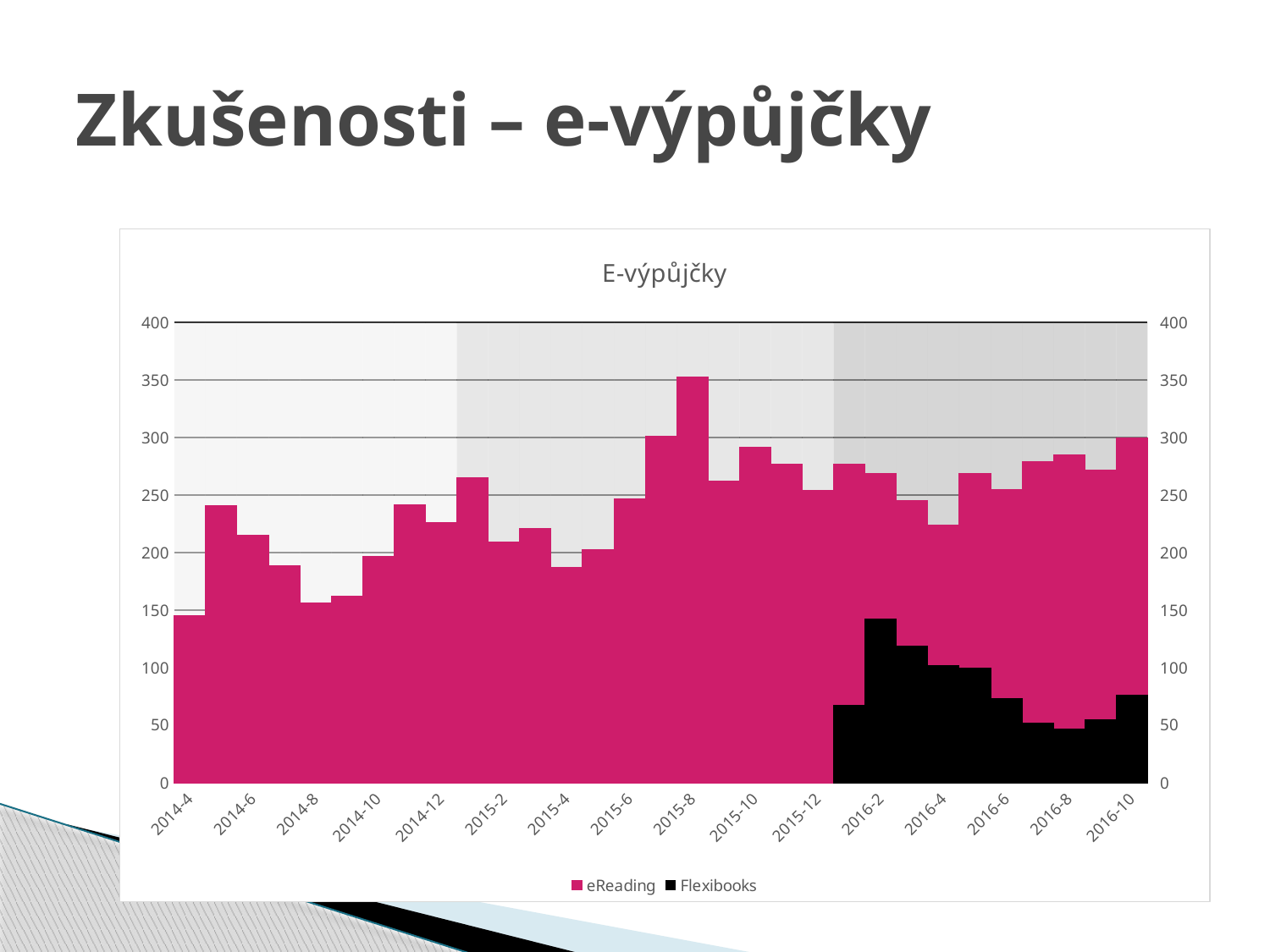
What kind of chart is shown on the slide? bar chart Is the stacked total for 2014-6 greater or less than 200? greater Is the Flexibooks value for 2016-8 greater or less than 100? less How many month labels are printed on the x axis? 16 What are the two series named in the legend? eReading and Flexibooks Is the Flexibooks value for 2016-2 greater or less than 100? greater What is the title of the chart? E-výpůjčky How many series does the legend list? 2 Which is larger, the stacked total for 2015-8 or for 2015-10? 2015-8 Does the Flexibooks series rise or fall from 2016-2 to 2016-8? fall